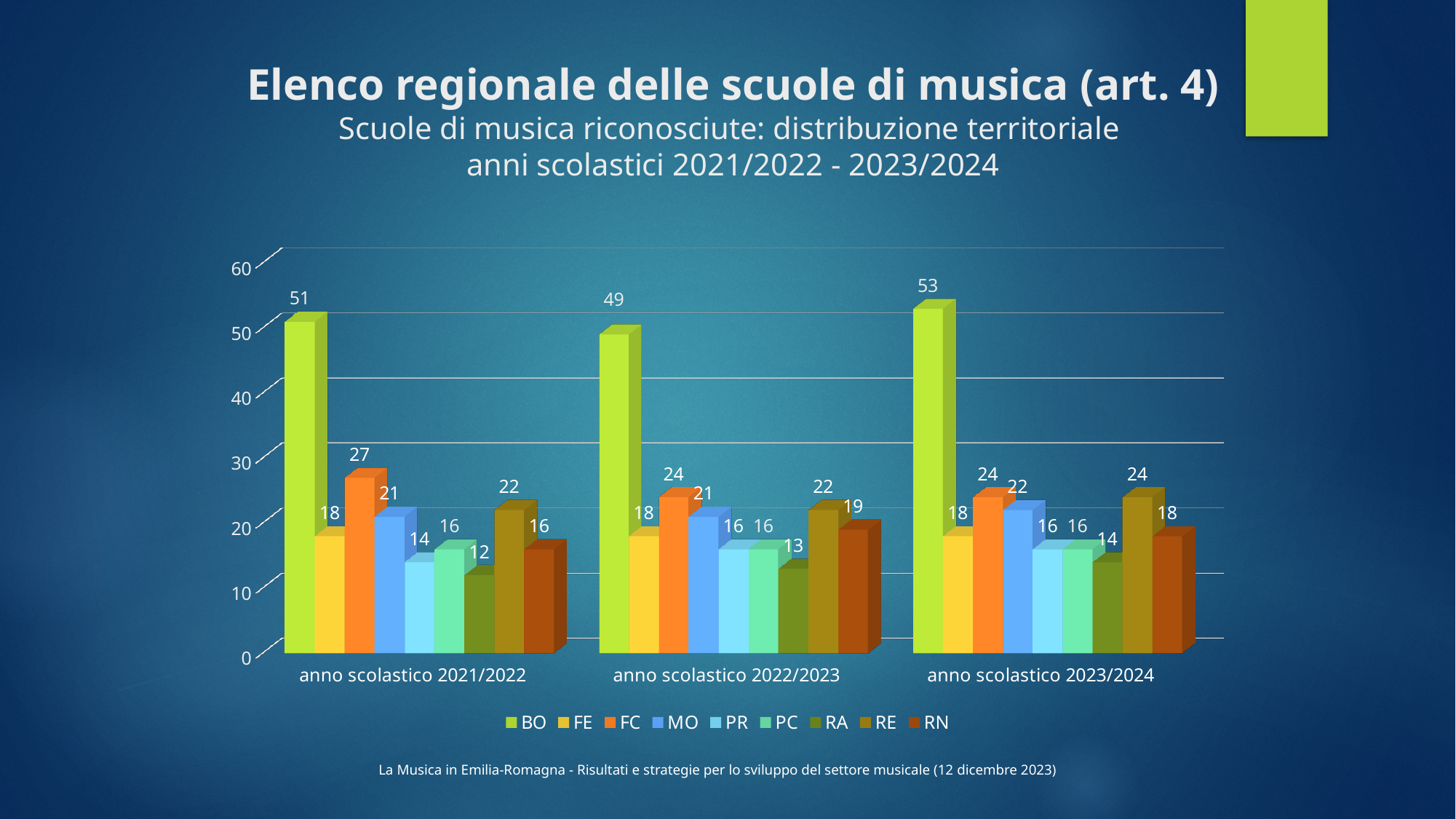
What is the value for RN in anno scolastico 2022/2023? 19 Which series has the highest value in anno scolastico 2023/2024? BO What is the value for BO in anno scolastico 2021/2022? 51 How many school-year categories are shown on the x axis? 3 What is the value for RE in anno scolastico 2023/2024? 24 What kind of chart is shown on the slide? bar chart Is the value for BO in anno scolastico 2022/2023 greater or less than 40? greater What is the difference between the BO values for anno scolastico 2023/2024 and anno scolastico 2022/2023? 4 What is the value for FC in anno scolastico 2021/2022? 27 How many series does the legend list? 9 Which is larger, the FC value in anno scolastico 2021/2022 or the FC value in anno scolastico 2022/2023? anno scolastico 2021/2022 Which series has the lowest value in anno scolastico 2021/2022? RA